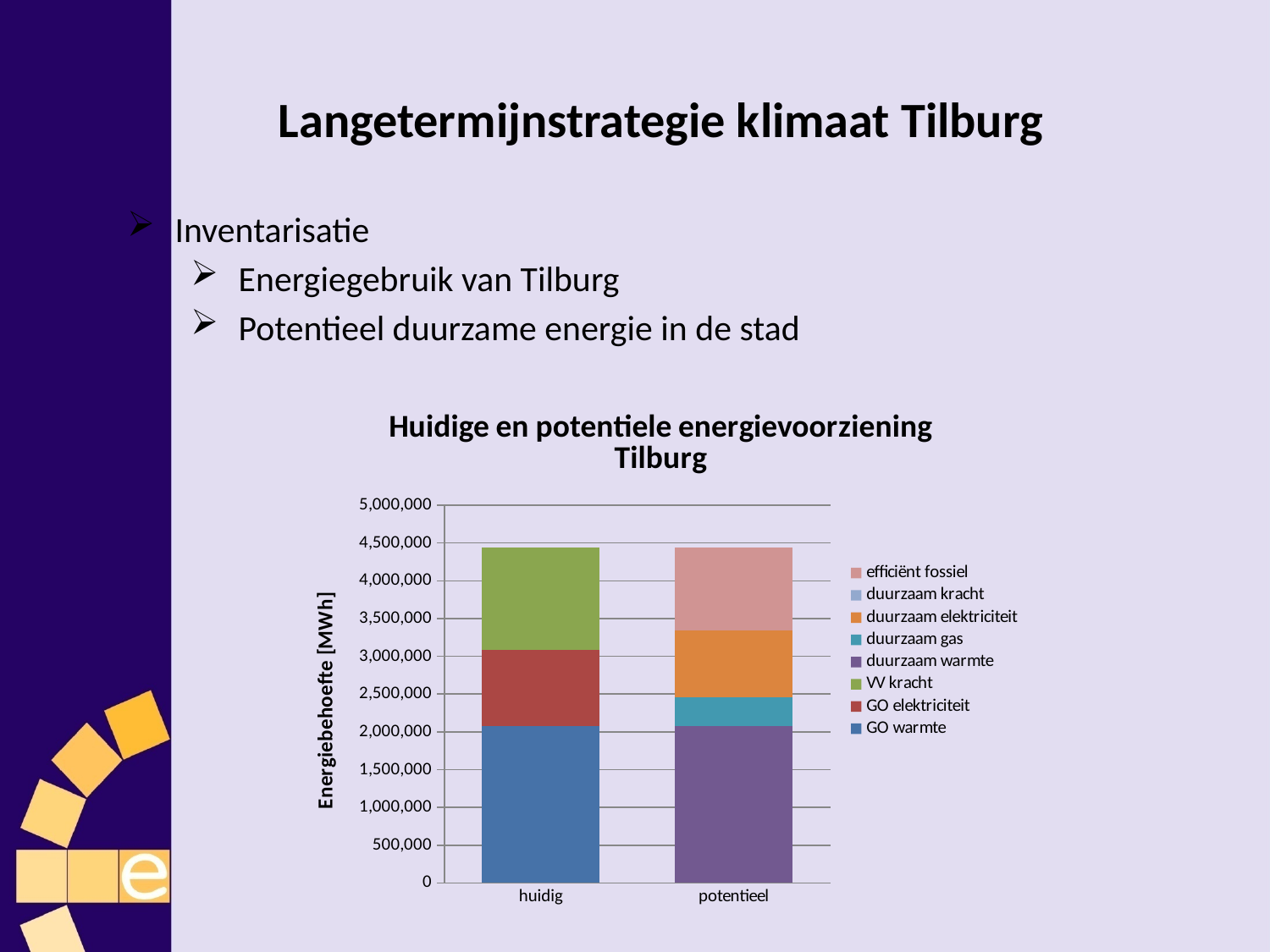
How many series does the chart legend list? 8 Is the 'duurzaam gas' segment of the 'potentieel' bar greater or less than 500,000? less Is the total height of the 'huidig' bar greater or less than 4,000,000? greater Is the 'GO warmte' segment of the 'huidig' bar greater or less than 1,500,000? greater What is the title of the chart? Huidige en potentiele energievoorziening Tilburg What kind of chart is shown on the slide? Stacked bar chart In the 'potentieel' bar, which segment is larger: 'duurzaam elektriciteit' or 'duurzaam gas'? duurzaam elektriciteit In the 'huidig' bar, which segment is larger: 'VV kracht' or 'GO elektriciteit'? VV kracht What is the label of the y axis? Energiebehoefte [MWh] How many categories are shown on the x axis of the chart? 2